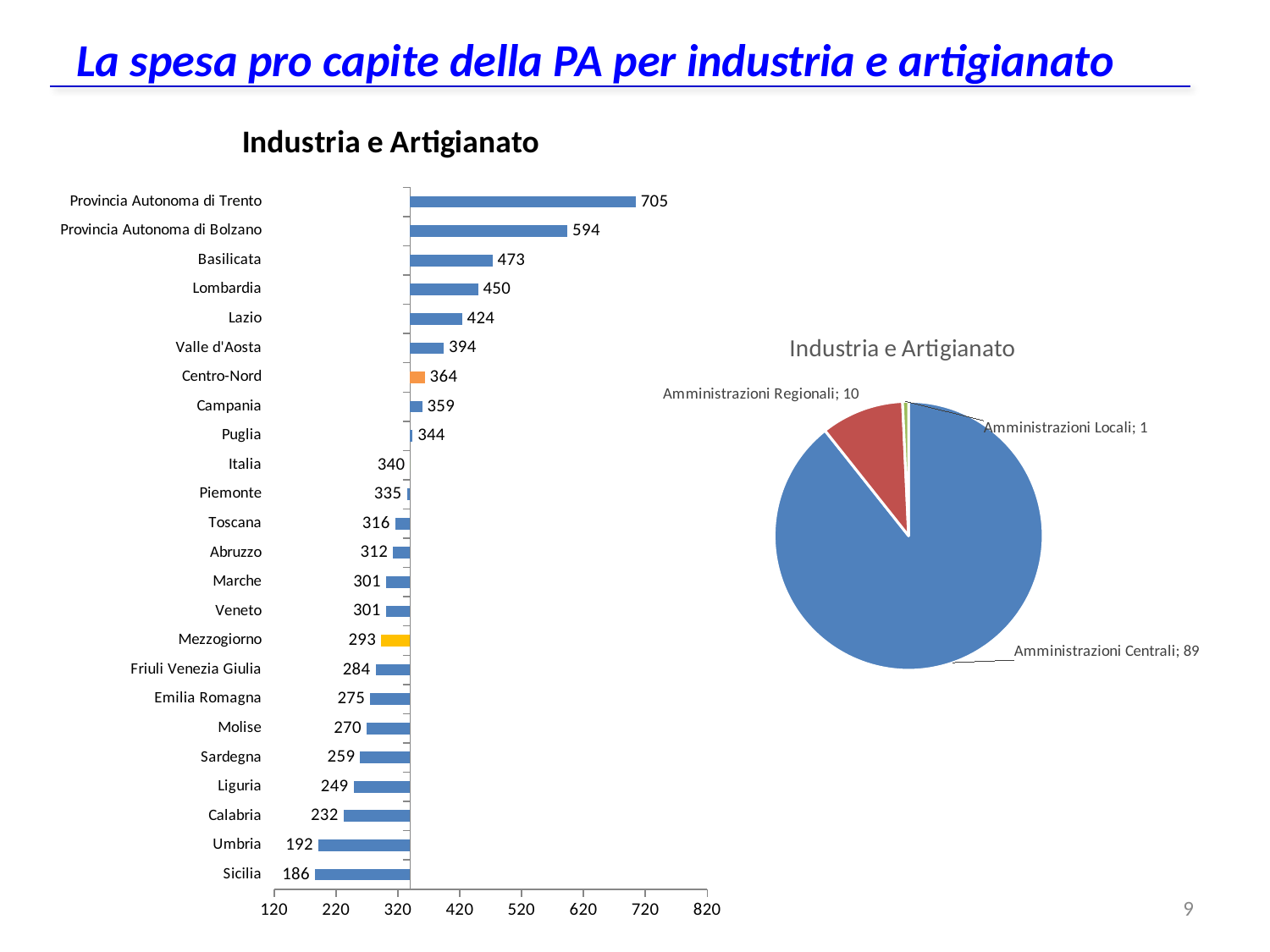
In the bar chart on the left, which category has the highest value? Provincia Autonoma di Trento In the bar chart on the left, what is the difference between the values for Provincia Autonoma di Trento and Provincia Autonoma di Bolzano? 111 In the pie chart on the right, what is the value for Amministrazioni Centrali? 89 How many slices does the pie chart on the right have? 3 In the bar chart on the left, what is the value for Provincia Autonoma di Trento? 705 In the bar chart on the left, which is larger, the value for Centro-Nord or the value for Mezzogiorno? Centro-Nord In the pie chart on the right, what is the value for Amministrazioni Regionali? 10 In the bar chart on the left, what is the value for Mezzogiorno? 293 In the bar chart on the left, which category has the lowest value? Sicilia In the bar chart on the left, what is the value for Lombardia? 450 How many categories are shown in the bar chart on the left? 24 What kind of chart is the chart on the left of the slide? Bar chart